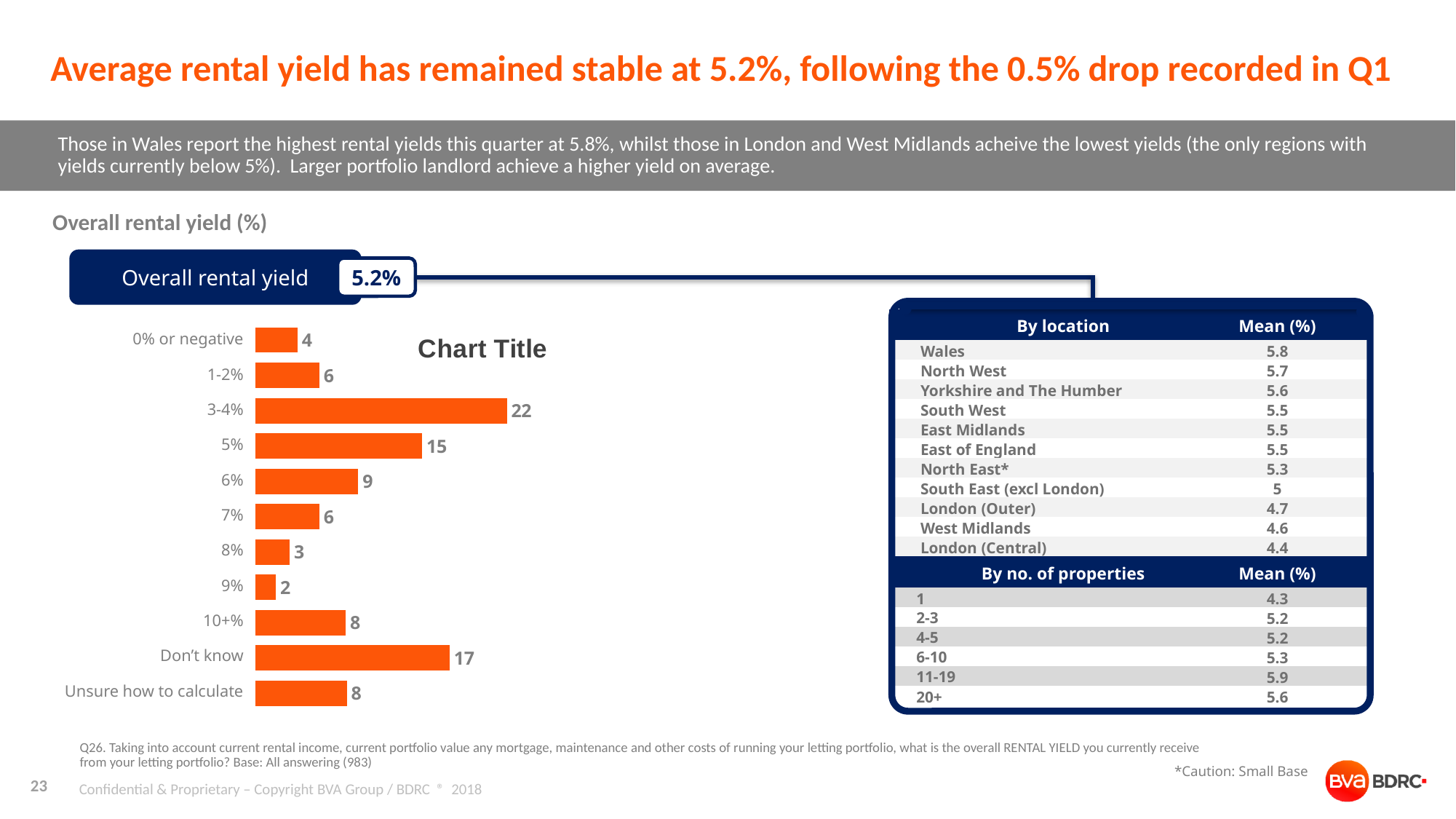
What is the value for the 3-4% category? 22 What is the value for the Don't know category? 17 What is the value for the 9% category? 2 Which category has the highest value in the bar chart? 3-4% How many categories are shown in the bar chart? 11 What title is printed on the bar chart? Chart Title Which category has the lowest value in the bar chart? 9% Which is larger, the value for 6% or the value for 10+%? 6% What is the difference between the values for Don't know and Unsure how to calculate? 9 What is the value for the 5% category? 15 What is the difference between the values for 3-4% and 5%? 7 What kind of chart is shown on the slide? bar chart